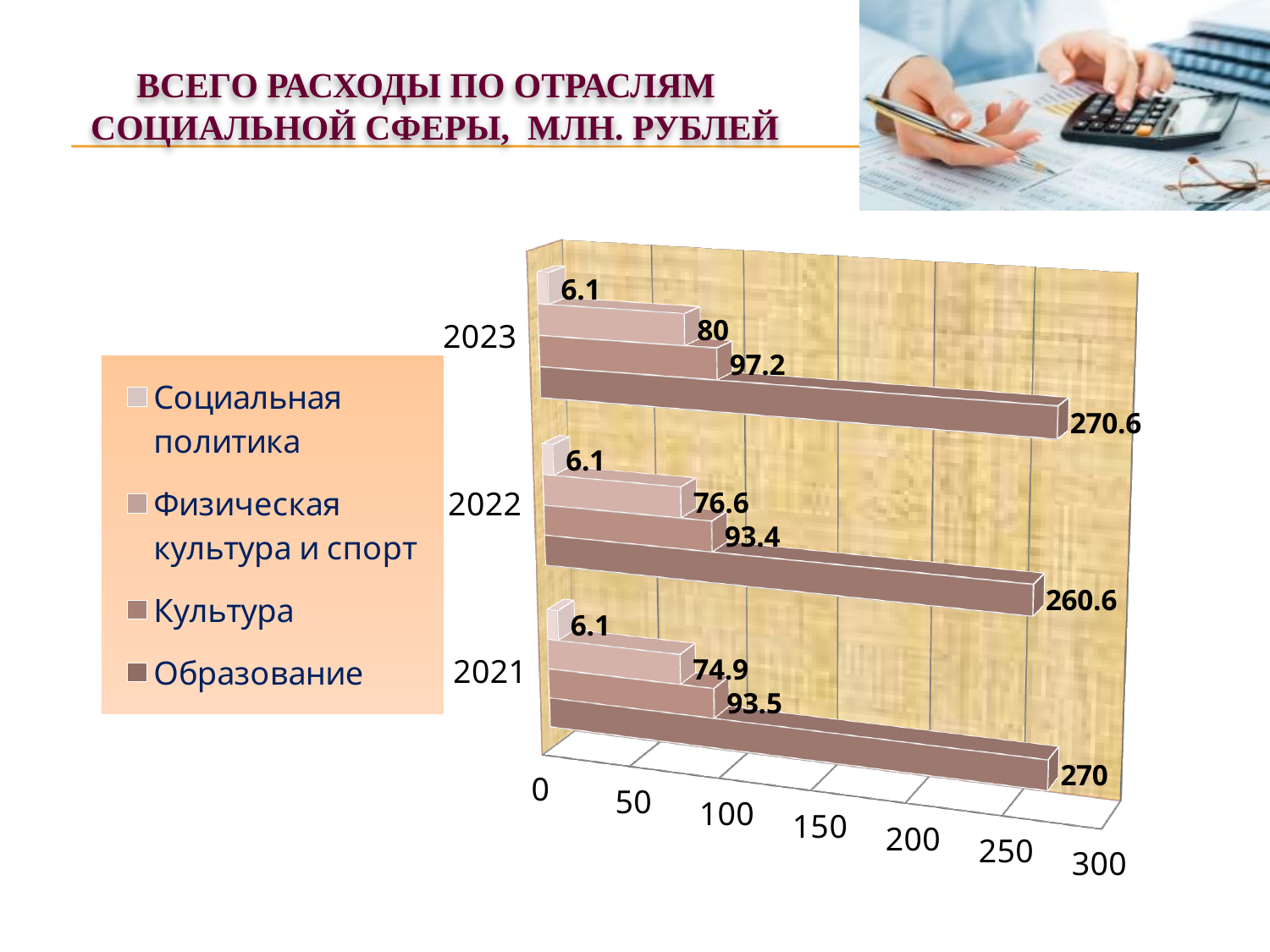
What is the title of the chart on the slide? ВСЕГО РАСХОДЫ ПО ОТРАСЛЯМ СОЦИАЛЬНОЙ СФЕРЫ, МЛН. РУБЛЕЙ How many years are shown on the chart? 3 In which year is the value for Физическая культура и спорт the highest? 2023 What is the value for Физическая культура и спорт in 2022? 76.6 What is the difference between the Образование values for 2023 and 2022? 10 In which year is the value for Образование the lowest? 2022 What is the value for Социальная политика in 2021? 6.1 How many series does the legend list? 4 What is the value for Культура in 2021? 93.5 What is the value for Образование in 2023? 270.6 Which is larger: Культура in 2021 or Культура in 2022? Культура in 2021 What kind of chart is shown on the slide? Bar chart